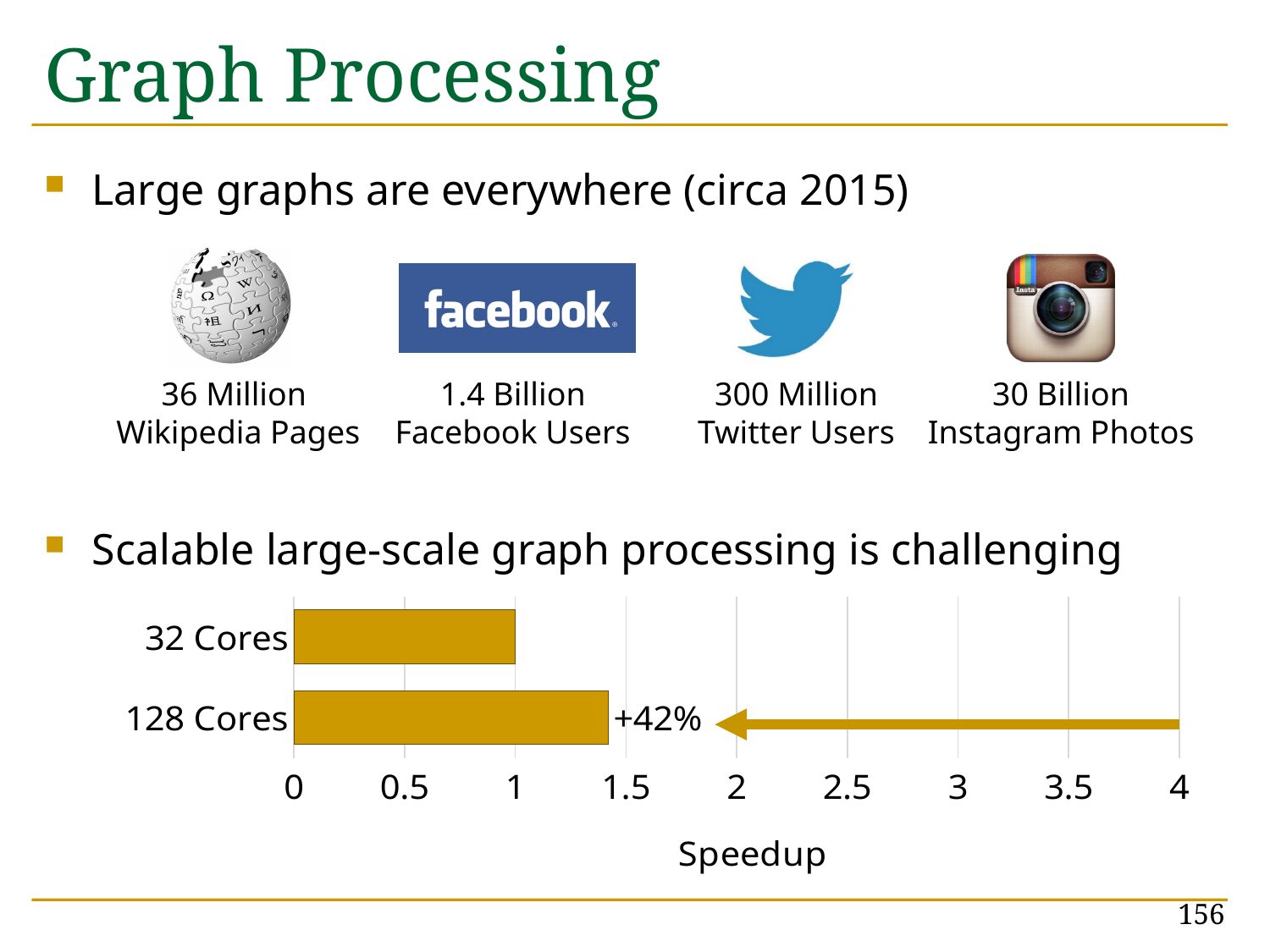
Which category has the lower speedup in the bar chart? 32 Cores How many categories does the bar chart show? 2 Is the speedup for 128 Cores greater or less than 2? less What annotation is printed next to the 128 Cores bar? +42% Is the speedup for 128 Cores greater or less than 1? greater Is the speedup for 128 Cores greater or less than 1.5? less Which category has the higher speedup in the bar chart? 128 Cores Is the speedup for 32 Cores larger or smaller than the speedup for 128 Cores? smaller What is the speedup value for 32 Cores in the bar chart? 1 What is the label on the x axis of the bar chart? Speedup What kind of chart is shown at the bottom of the slide? bar chart What is the maximum value shown on the x axis of the bar chart? 4